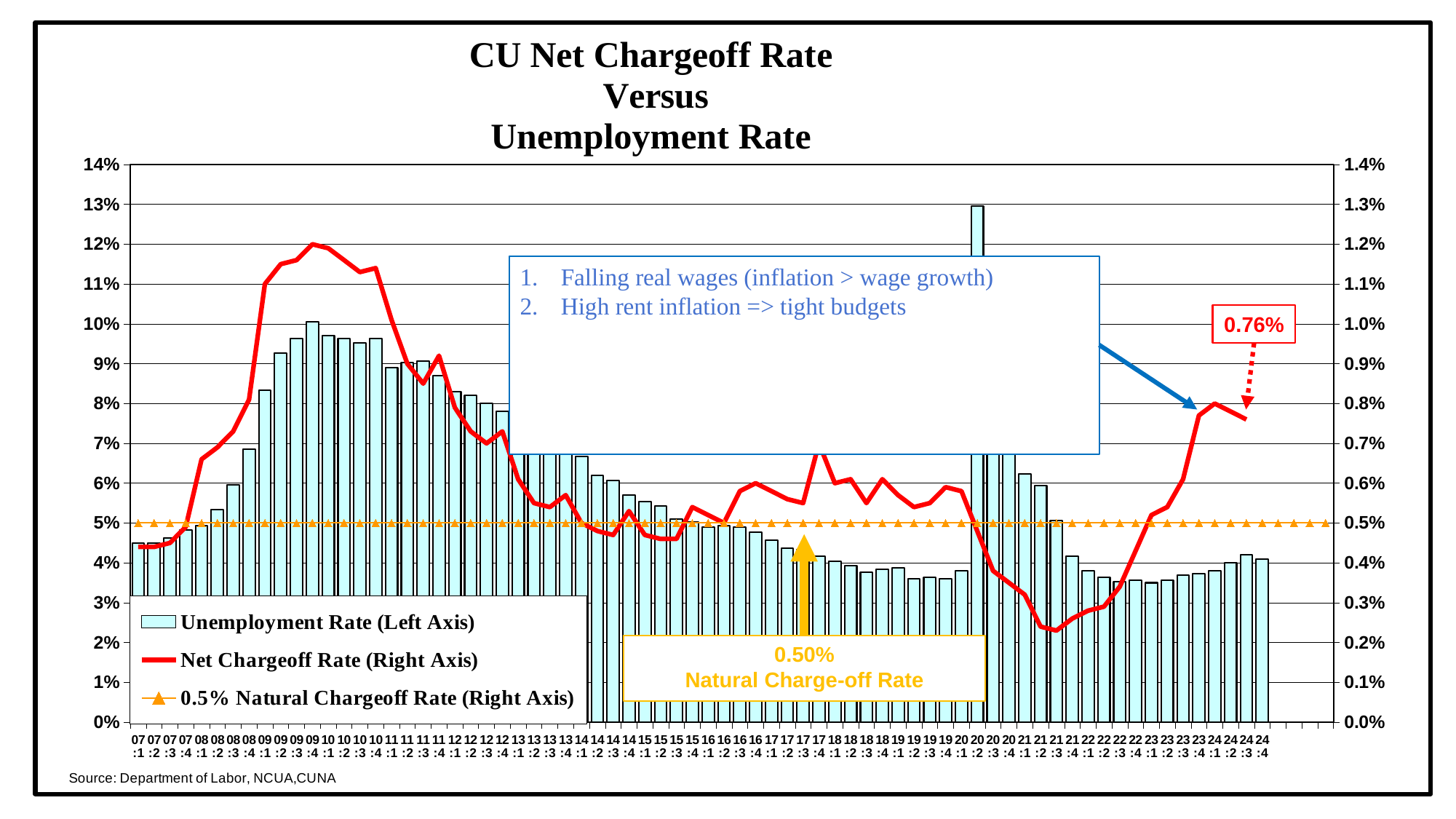
What kind of chart is shown on the slide? combination bar and line chart How many series does the legend list? 3 Is the Unemployment Rate in 20:2 greater or less than 12%? greater What value is given for the Natural Charge-off Rate? 0.50% In which quarter is the Unemployment Rate highest? 20:2 Is the Net Chargeoff Rate in 21:3 greater or less than 0.3%? less What is the most recent Net Chargeoff Rate value labeled on the chart? 0.76% By how much does the labeled 0.76% Net Chargeoff Rate exceed the 0.50% Natural Charge-off Rate? 0.26% Does the Net Chargeoff Rate rise or fall from 21:3 to 23:4? rises Which axis is the Unemployment Rate plotted on, according to the legend? Left Axis Is the Net Chargeoff Rate in 09:4 greater or less than 1.1%? greater Which is larger, the Unemployment Rate in 07:1 or in 09:4? 09:4